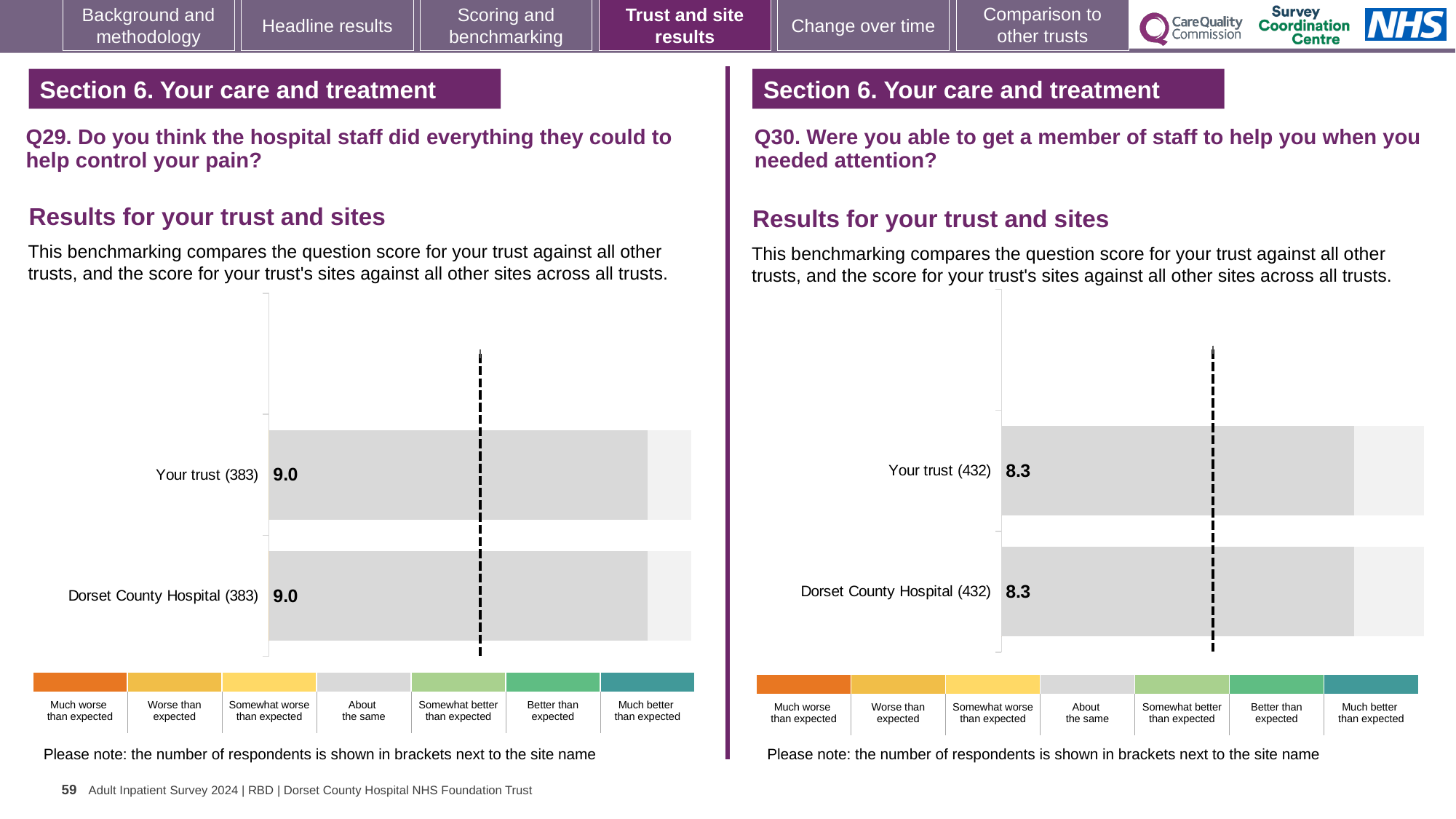
In the Q30 chart on the right, what is the score for Dorset County Hospital? 8.3 In the Q29 chart on the left, what is the score for Dorset County Hospital? 9.0 In the Q30 chart on the right, how many respondents are shown in brackets next to Dorset County Hospital? 432 How many bars are plotted in the Q29 chart on the left? 2 What kind of chart is used for the Q30 results on the right? bar chart In the Q29 chart on the left, how many respondents are shown in brackets next to Your trust? 383 In the Q29 chart on the left, what is the score for Your trust? 9.0 How many bars are plotted in the Q30 chart on the right? 2 In the Q30 chart on the right, is the score for Your trust larger than, smaller than, or the same as the score for Dorset County Hospital? the same Which chart has the higher score for Your trust, the Q29 chart on the left or the Q30 chart on the right? Q29 chart on the left In the Q30 chart on the right, what is the score for Your trust? 8.3 In the Q29 chart on the left, what is the difference between the score for Your trust and the score for Dorset County Hospital? 0.0